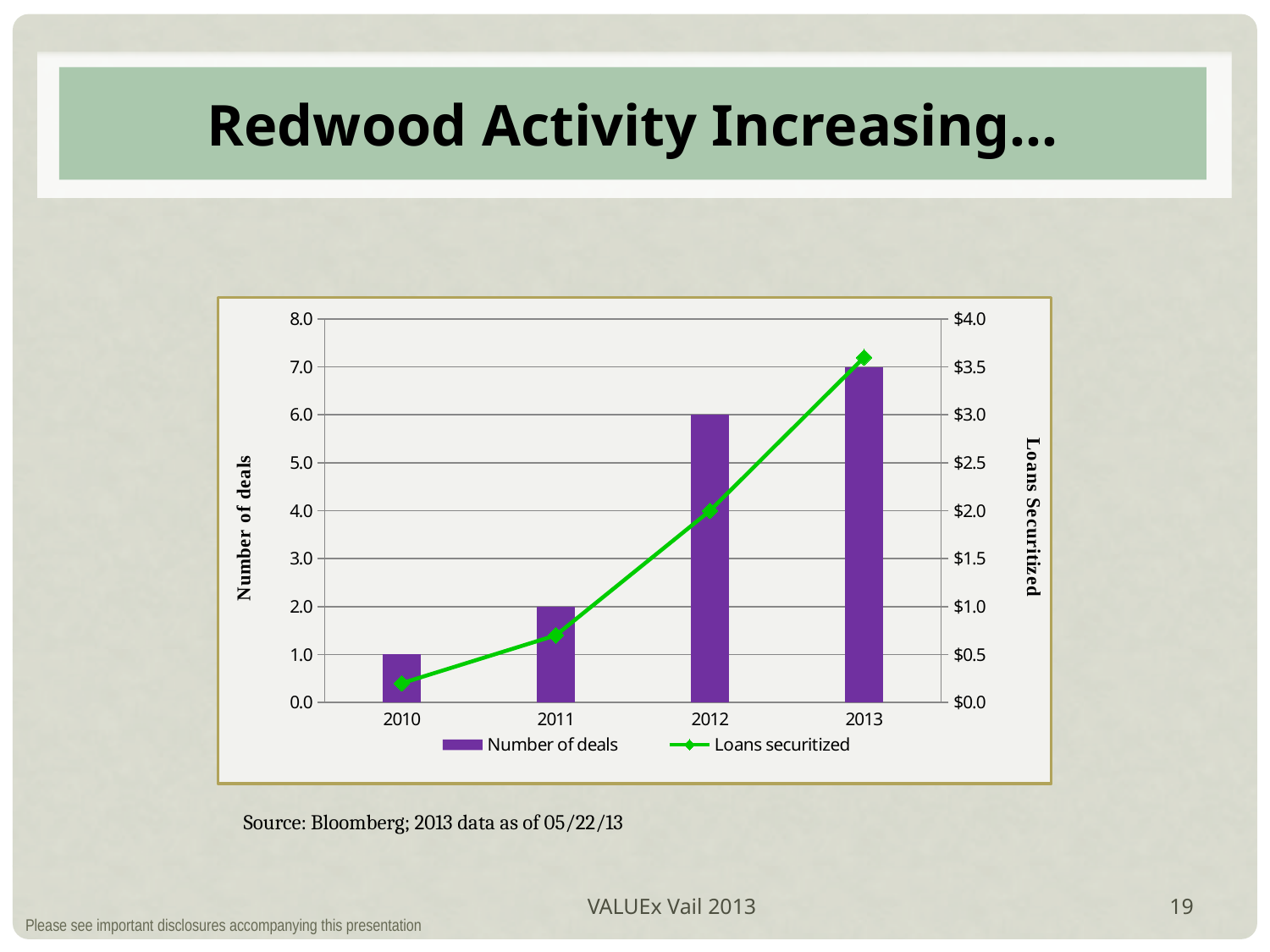
Which year has more deals, 2011 or 2012? 2012 What is the number of deals in 2012? 6.0 What is the value of loans securitized in 2012? $2.0 How many series does the legend list? 2 Which year has the highest number of deals? 2013 Does the number of deals rise or fall from 2010 to 2013? rise Is the value of loans securitized in 2013 greater or less than $3.0? greater Which year has the lowest number of deals? 2010 What is the number of deals in 2013? 7.0 Is the value of loans securitized in 2010 greater or less than $0.5? less What is the number of deals in 2010? 1.0 What is the difference in the number of deals between 2012 and 2011? 4.0